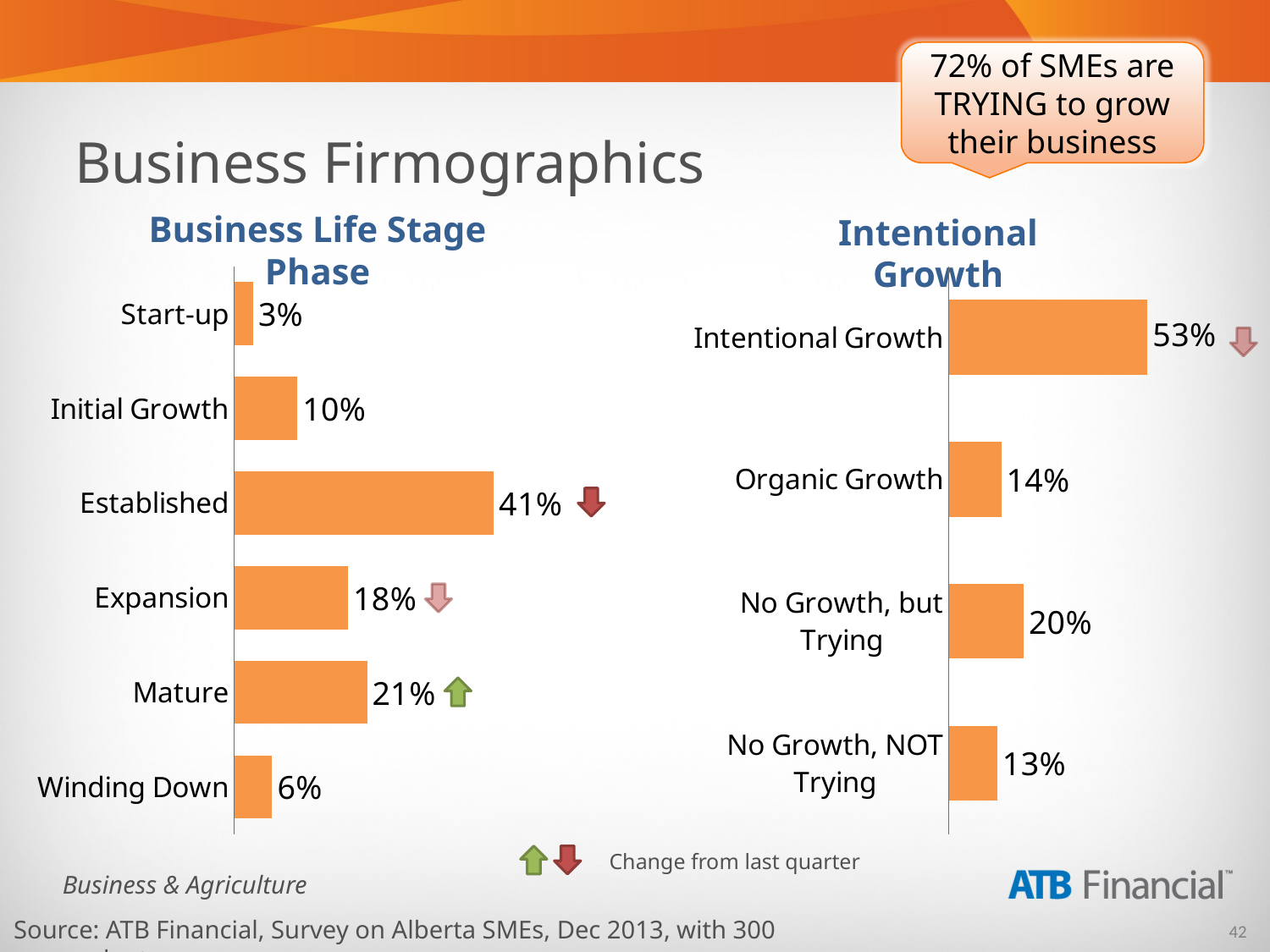
What kind of chart is the Business Life Stage Phase chart? Bar chart In the Intentional Growth chart, what is the difference between Intentional Growth and Organic Growth? 39% In the Business Life Stage Phase chart, what is the value for Established? 41% In the Business Life Stage Phase chart, what is the value for Mature? 21% In the Business Life Stage Phase chart, which category has the highest value? Established In the Intentional Growth chart, what is the value for No Growth, but Trying? 20% In the Business Life Stage Phase chart, which category has the lowest value? Start-up In the Intentional Growth chart, which is larger: No Growth, but Trying or No Growth, NOT Trying? No Growth, but Trying In the Intentional Growth chart, what is the value for Organic Growth? 14% In the Business Life Stage Phase chart, what is the difference between Established and Expansion? 23% In the Business Life Stage Phase chart, how many categories are shown? 6 In the Intentional Growth chart, which category has the highest value? Intentional Growth